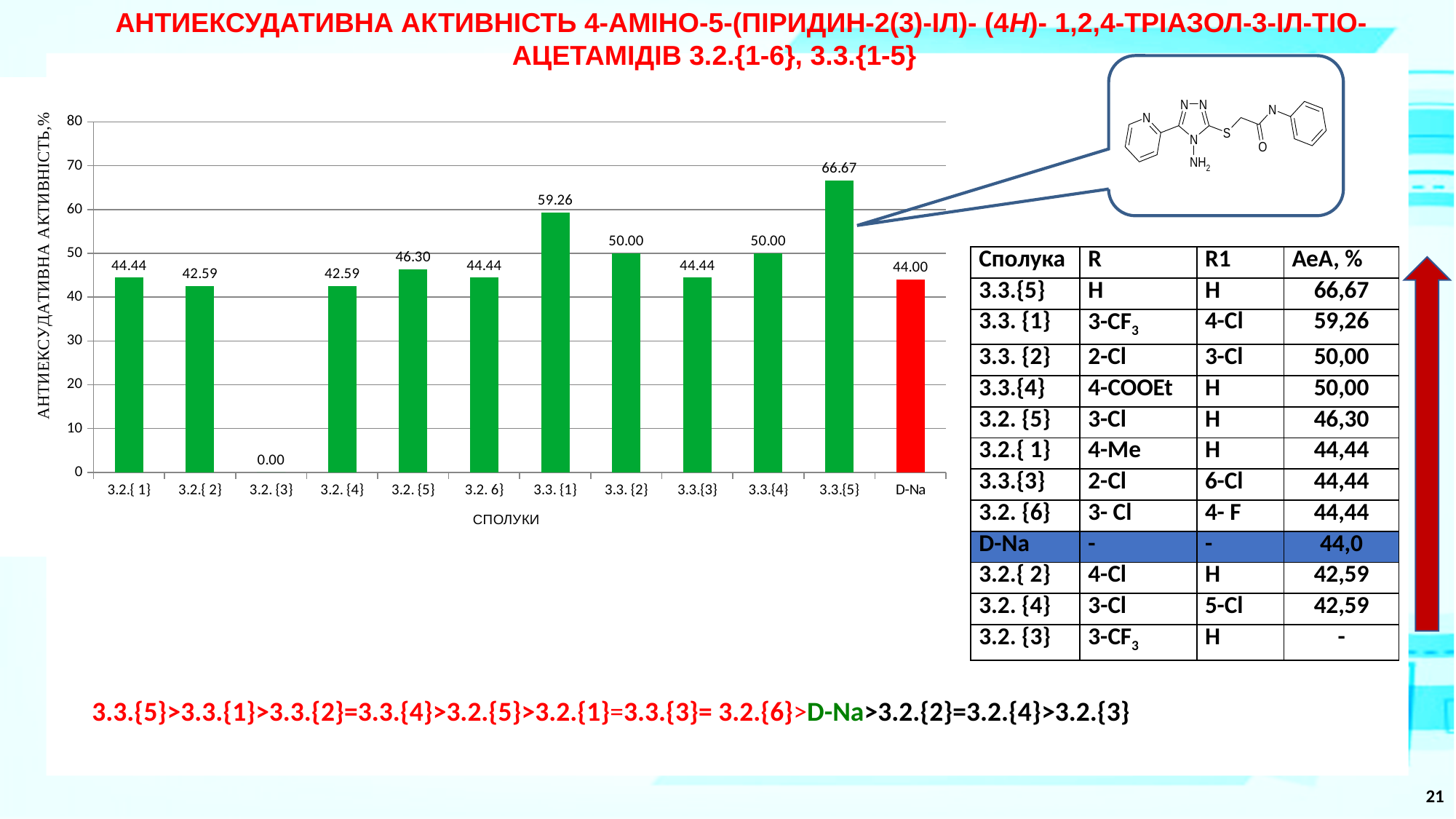
What value is shown for D-Na in the chart? 44.00 How many categories are shown on the x axis of the chart? 12 What is the difference between the values for 3.3.{2} and D-Na? 6.00 Which category has the highest value in the chart? 3.3.{5} Which category has the lowest value in the chart? 3.2.{3} Is the value for 3.3.{5} greater or less than 60? greater What is the difference between the values for 3.3.{5} and 3.3.{1}? 7.41 Which is larger, the value for 3.2.{5} or the value for 3.2.{4}? 3.2.{5} What value is shown for 3.3.{1} in the chart? 59.26 What value is shown for 3.2.{5} in the chart? 46.30 Which bar in the chart is coloured red rather than green? D-Na What kind of chart is shown on the slide? bar chart